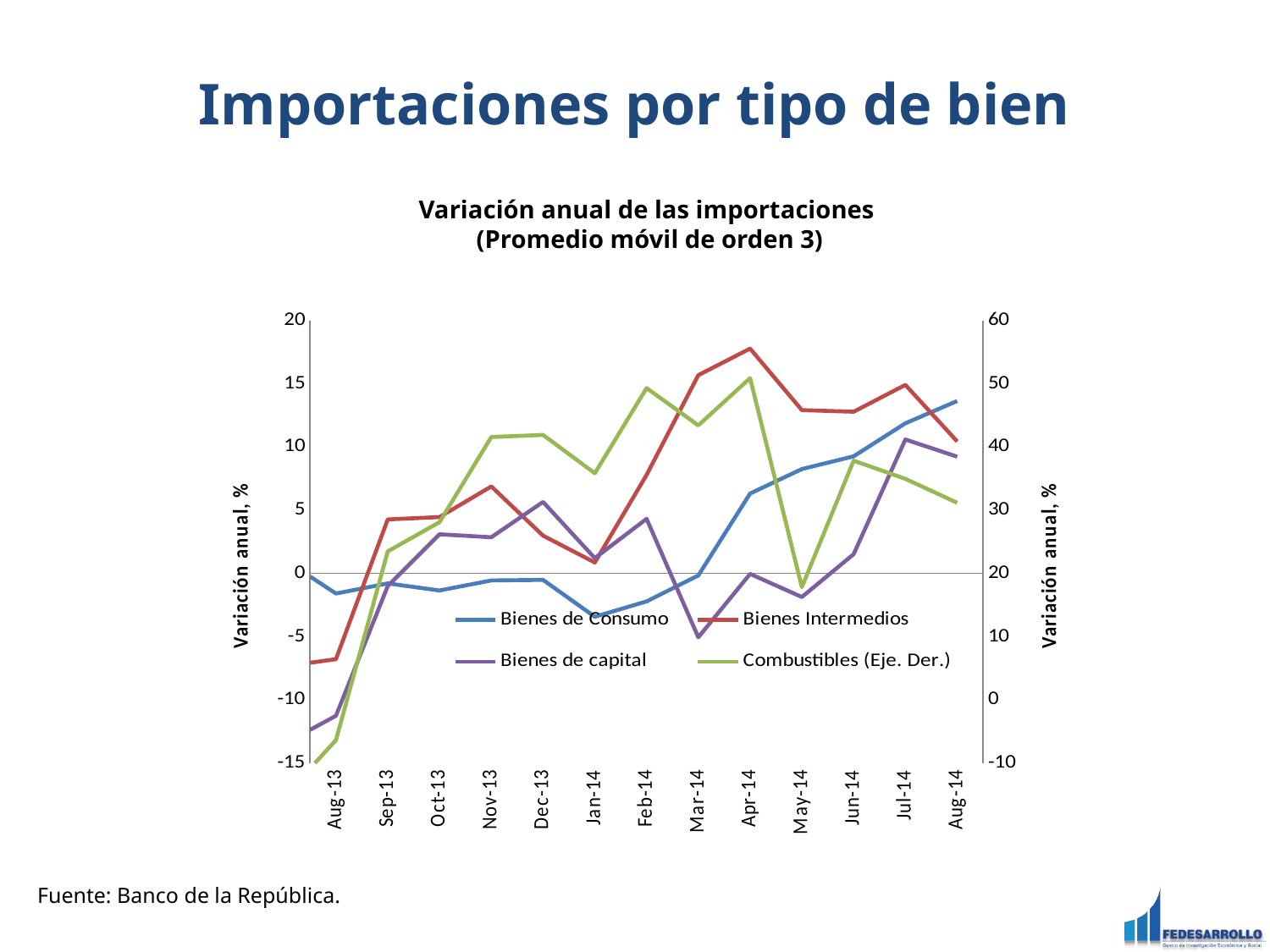
Is the value for Bienes de Consumo in Aug-14 greater or less than 10? greater How many months are labelled on the x axis of the chart? 13 Is the value for Bienes Intermedios in Apr-14 greater or less than 15? greater In which month does the Bienes de Consumo series reach its highest value? Aug-14 Which series is plotted on the right-hand axis (Eje. Der.)? Combustibles Is the value for Bienes de capital in Mar-14 greater or less than 0? less What is the title of the chart? Variación anual de las importaciones (Promedio móvil de orden 3) In which month does the Bienes de capital series reach its highest value? Jul-14 In Aug-14, which is larger: Bienes de Consumo or Bienes Intermedios? Bienes de Consumo How many series does the chart legend list? 4 What kind of chart is shown on the slide? line chart In which month does the Bienes Intermedios series reach its highest value? Apr-14